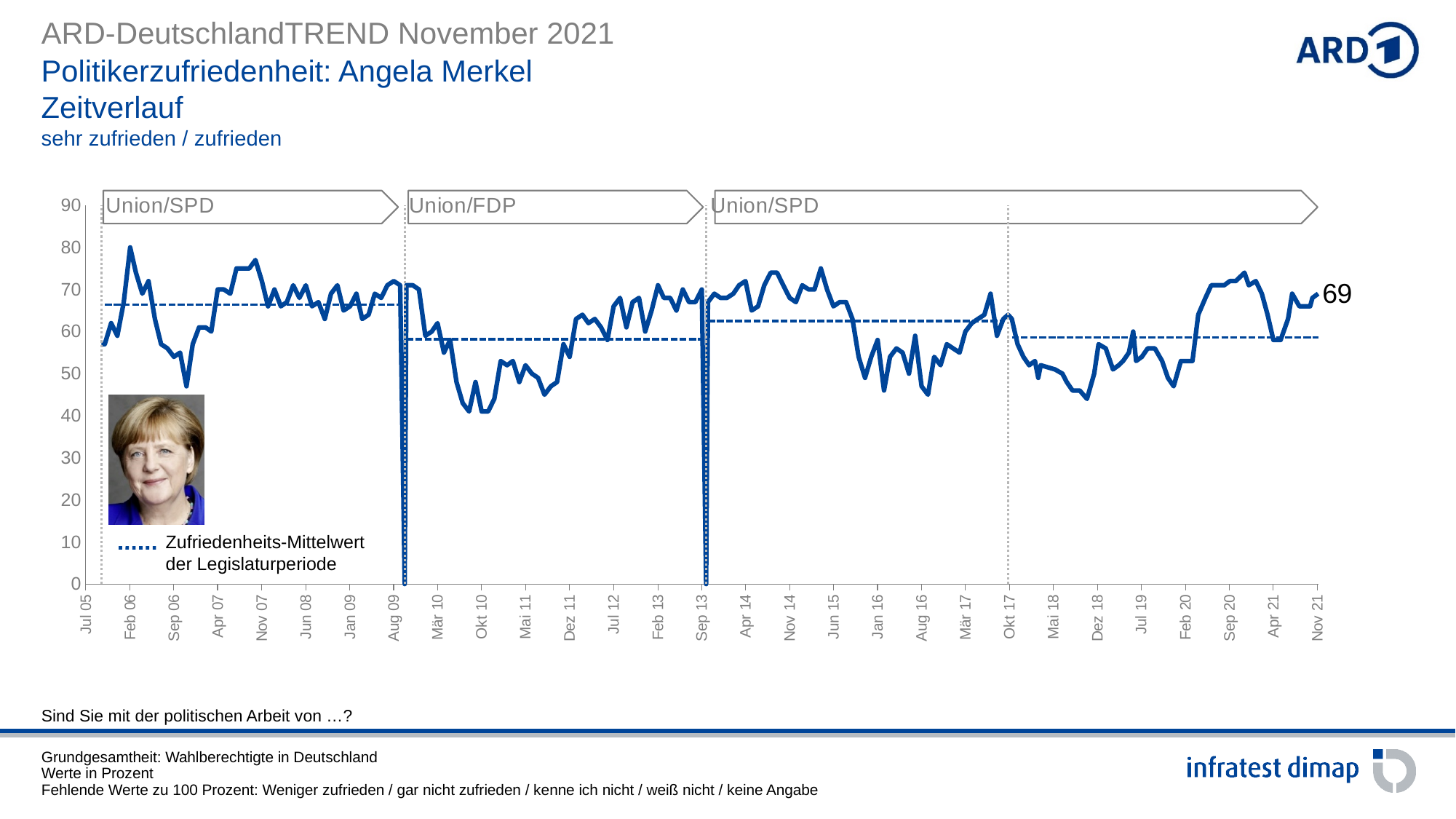
How many coalition period labels are shown above the chart? 3 Around which x-axis label does the line reach its highest value? Feb 06 What is the highest value shown on the y axis? 90 What kind of chart is shown on the slide? line chart What does the dashed line in the legend represent? Zufriedenheits-Mittelwert der Legislaturperiode Does the line rise or fall between Feb 06 and Sep 06? fall What is the value printed at the end of the line for Nov 21? 69 Does the line rise or fall between Apr 21 and Nov 21? rise Is the value for Okt 10 greater or less than 50? less Is the value for Sep 20 greater or less than 60? greater Is the value for Feb 06 greater or less than 70? greater